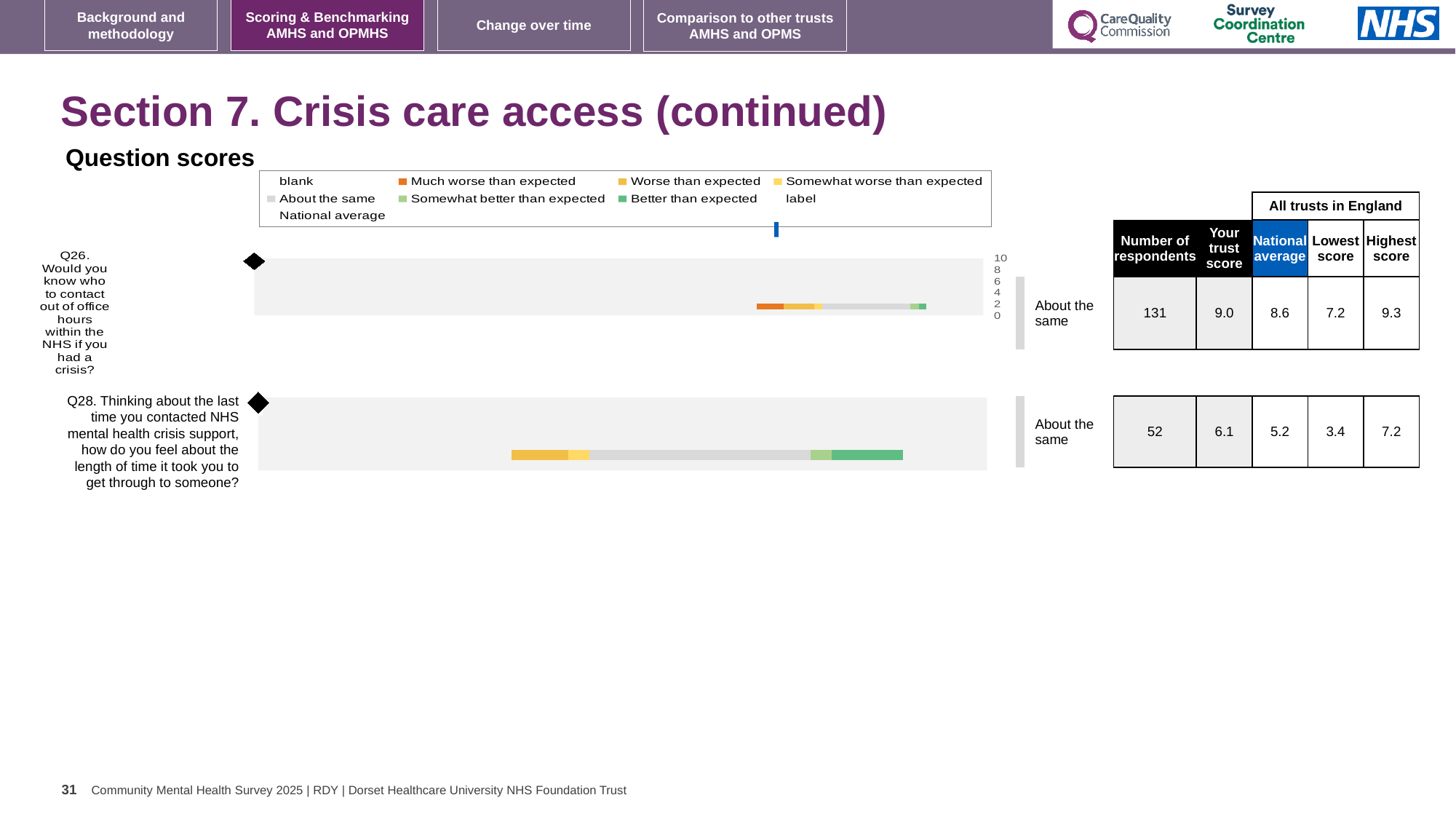
Which question has the higher trust score, Q26 or Q28? Q26 In the legend, which colour represents 'Much worse than expected'? orange What is the national average for Q28? 5.2 What benchmark category label is shown next to the Q28 bar? About the same What is the lowest score among all trusts in England for Q28? 3.4 For Q26, which is larger: the trust score or the national average? trust score (9.0) How many questions (bars) are plotted on the slide? 2 What is the difference between the highest score and the lowest score for Q26? 2.1 What is the number of respondents for Q26? 131 By how much does the Q28 trust score exceed the Q28 national average? 0.9 What is the trust score for Q26? 9.0 What kind of chart is used to show the question scores for Q26 and Q28? bar chart